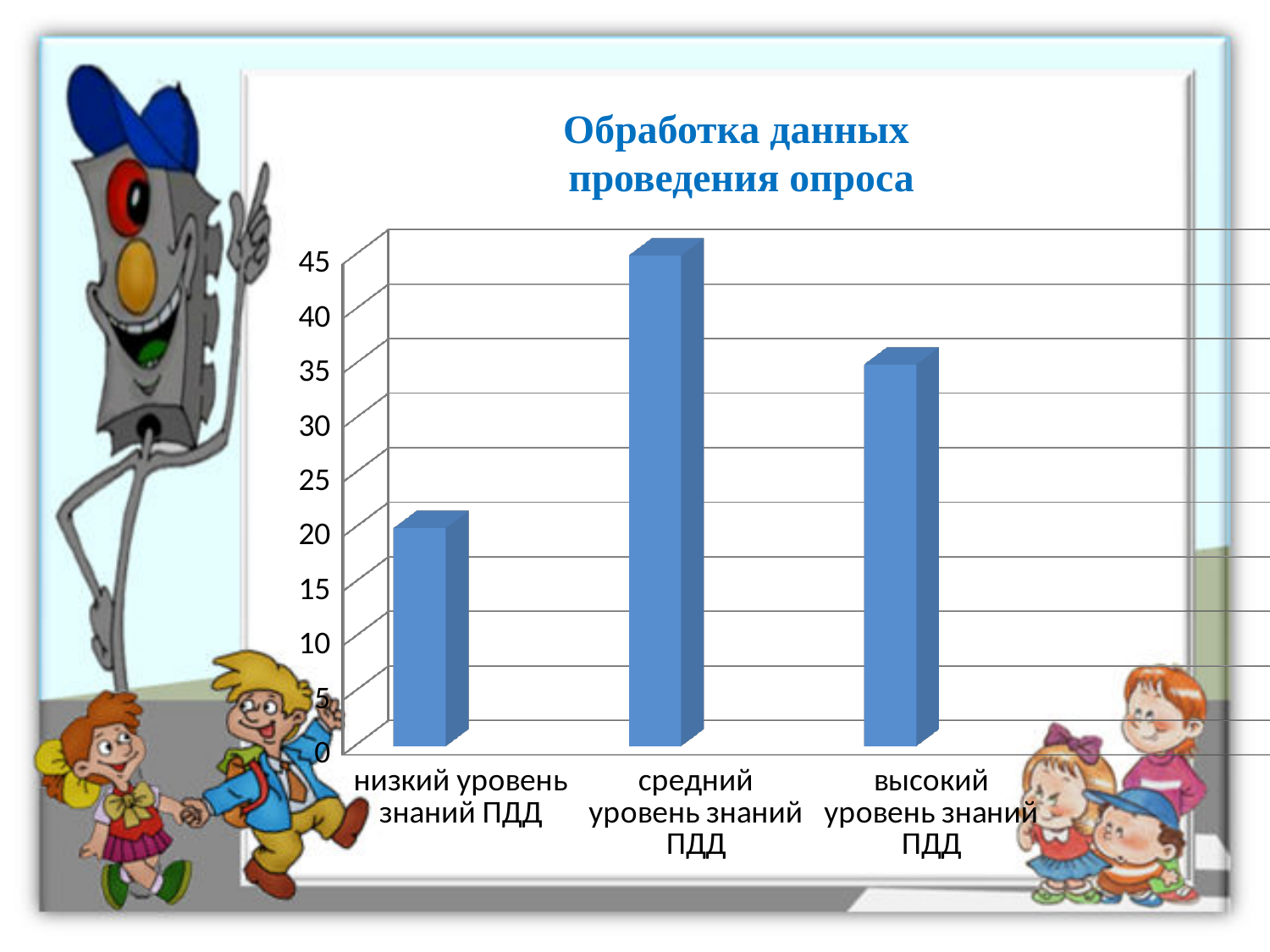
Which category has the lowest value? низкий уровень знаний ПДД How many categories are plotted in the chart? 3 What is the title of the chart? Обработка данных проведения опроса Which category has the highest value? средний уровень знаний ПДД What is the difference between the values for средний уровень знаний ПДД and низкий уровень знаний ПДД? 25 What is the value for низкий уровень знаний ПДД? 20 What is the value for высокий уровень знаний ПДД? 35 Is the value for низкий уровень знаний ПДД greater or less than 25? less Is the value for высокий уровень знаний ПДД greater or less than 30? greater What kind of chart is shown on the slide? bar chart Which is larger: the value for высокий уровень знаний ПДД or the value for низкий уровень знаний ПДД? высокий уровень знаний ПДД What is the value for средний уровень знаний ПДД? 45